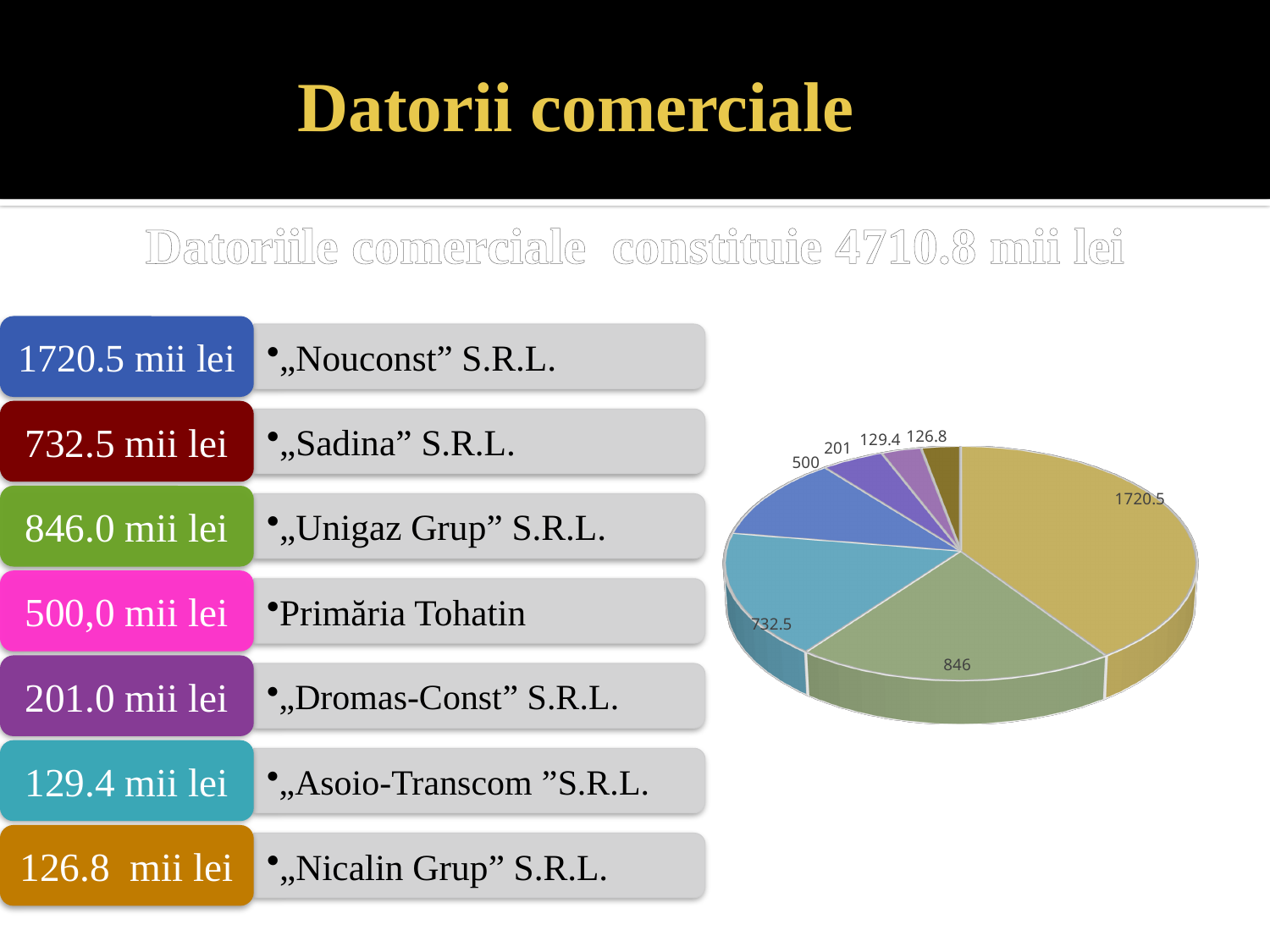
What value is labelled on the green slice of the pie chart? 846 Which is larger on the pie chart, the slice labelled 732.5 or the slice labelled 500? 732.5 What value is labelled on the teal slice of the pie chart? 732.5 What is the difference between the two largest values labelled on the pie chart, 1720.5 and 846? 874.5 What is the title of the slide containing the pie chart? Datorii comerciale Which is larger on the pie chart, the slice labelled 846 or the slice labelled 201? 846 What kind of chart is shown on the slide? pie chart How many slices does the pie chart have? 7 What is the smallest value labelled on the pie chart? 126.8 What value is labelled on the largest slice of the pie chart? 1720.5 What is the largest value labelled on the pie chart? 1720.5 What is the difference between the slices labelled 500 and 201 on the pie chart? 299